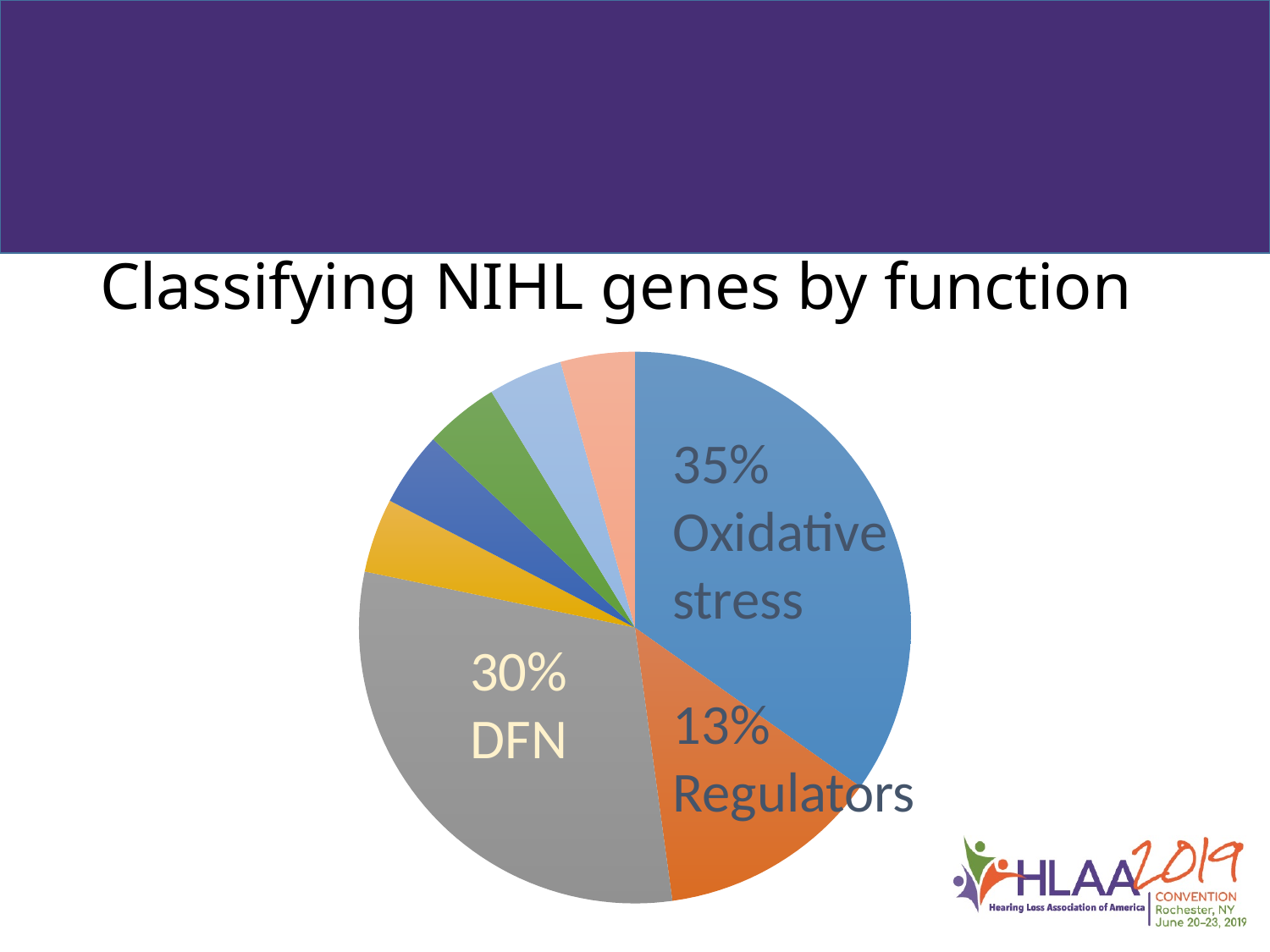
What kind of chart is shown on the slide? pie chart Which is larger, the share for DFN or the share for Regulators? DFN What colour is the slice labelled DFN? grey What is the title of the slide containing the chart? Classifying NIHL genes by function What percentage of the pie is labelled Regulators? 13% Which labelled category has the largest share of the pie? Oxidative stress What is the difference in percentage points between Oxidative stress and Regulators? 22 What percentage of the pie is labelled DFN? 30% What percentage of the pie is labelled Oxidative stress? 35% What is the difference in percentage points between DFN and Regulators? 17 What is the difference in percentage points between Oxidative stress and DFN? 5 How many slices does the pie chart have? 8